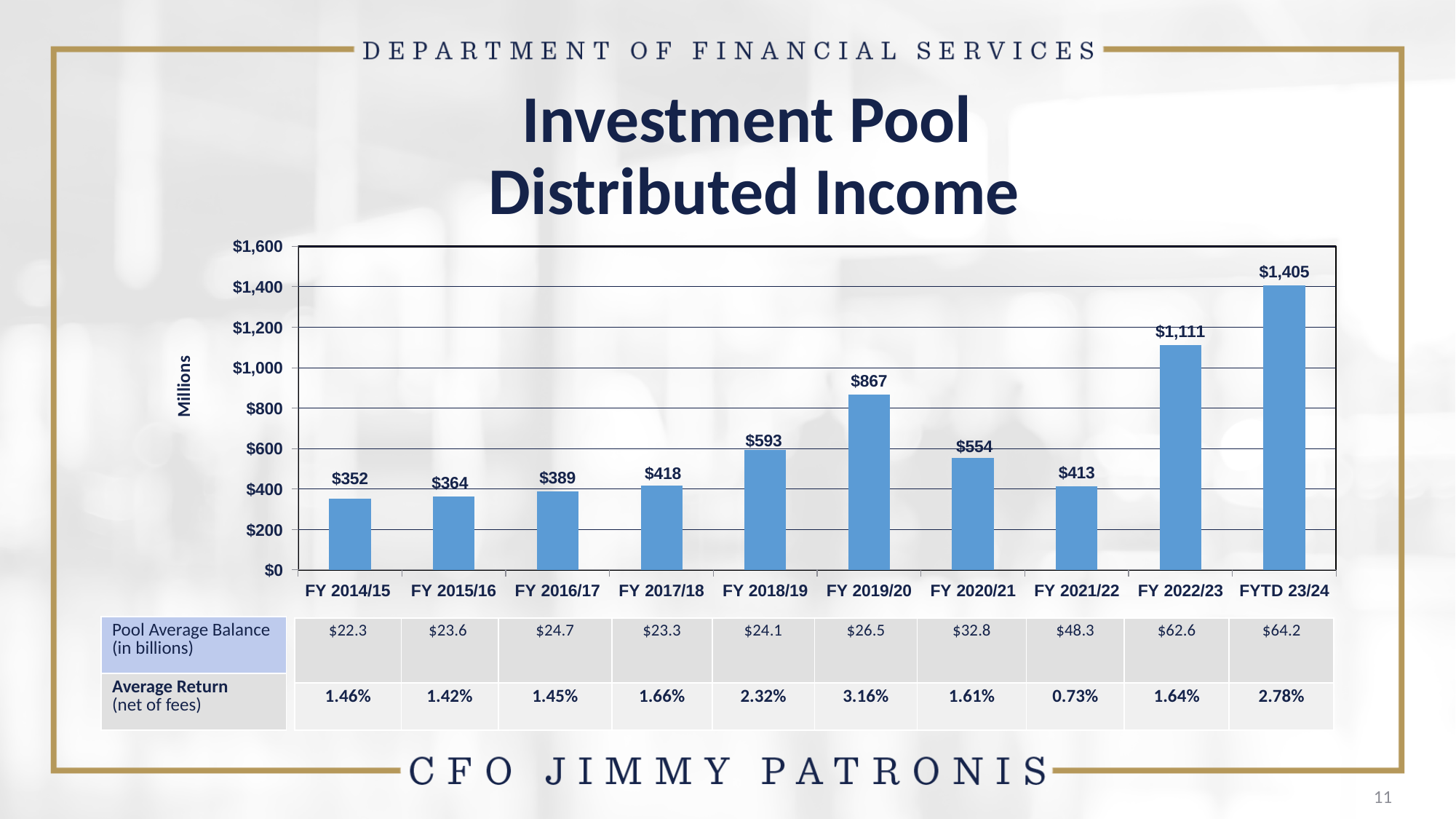
What is the distributed income for FY 2014/15? $352 What is the label on the vertical axis of the chart? Millions Which fiscal year has the highest distributed income? FYTD 23/24 What is the difference in distributed income between FYTD 23/24 and FY 2022/23? $294 What is the distributed income for FY 2019/20? $867 Which fiscal year has the lowest distributed income? FY 2014/15 Is the distributed income for FY 2022/23 greater or less than $1,000? greater What is the distributed income for FY 2021/22? $413 What kind of chart is shown on the slide? Bar chart Which is larger, the distributed income for FY 2017/18 or FY 2021/22? FY 2017/18 What is the difference in distributed income between FY 2018/19 and FY 2020/21? $39 How many fiscal years are shown on the chart? 10